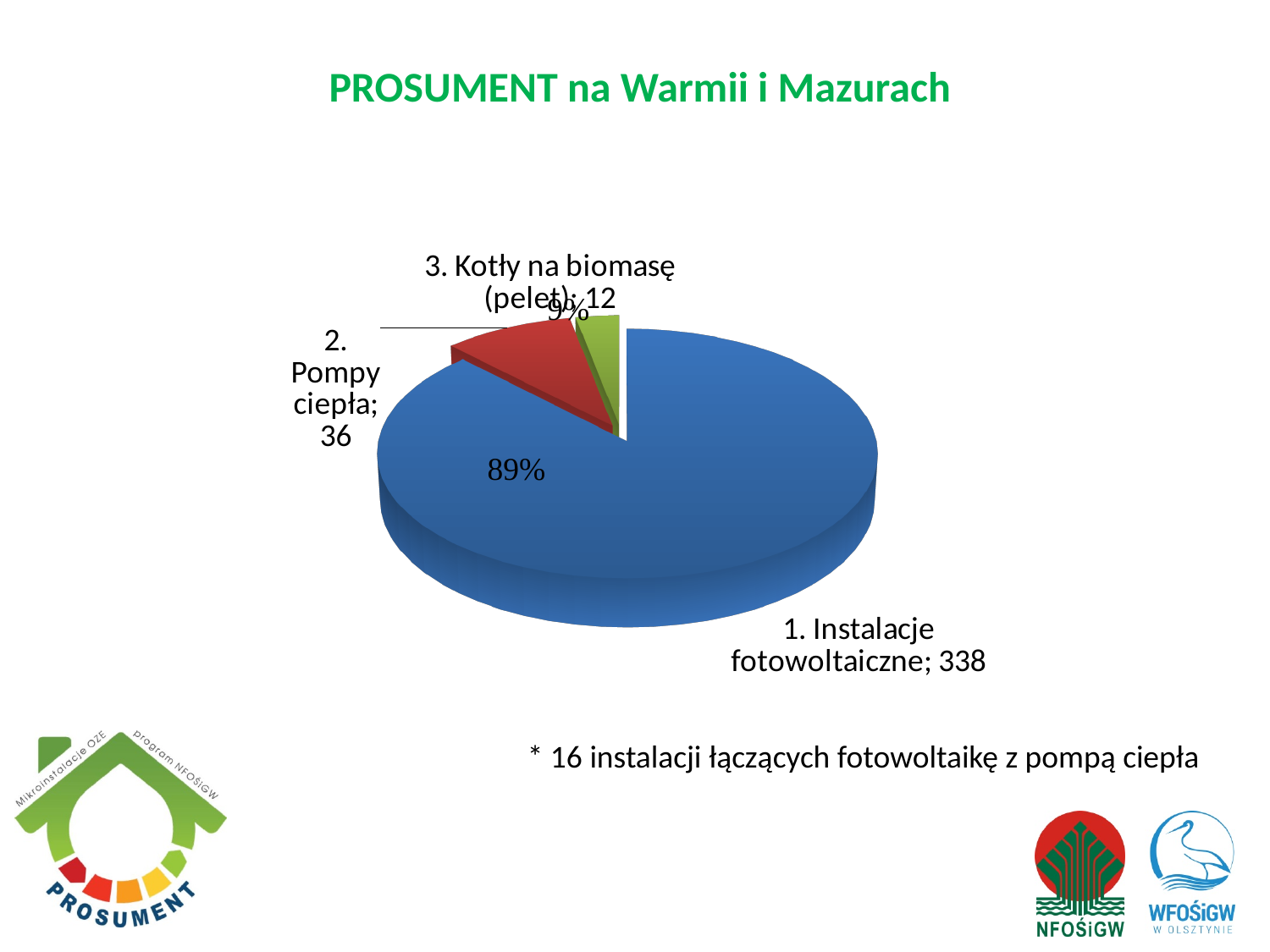
What is the difference between the values for "2. Pompy ciepła" and "3. Kotły na biomasę (pelet)"? 24 What is the title of the slide containing the pie chart? PROSUMENT na Warmii i Mazurach Which category has the smallest slice of the pie? 3. Kotły na biomasę (pelet) What is the value for "2. Pompy ciepła"? 36 What is the value for "3. Kotły na biomasę (pelet)"? 12 Which category has the largest slice of the pie? 1. Instalacje fotowoltaiczne Which is larger, the value for "2. Pompy ciepła" or for "3. Kotły na biomasę (pelet)"? 2. Pompy ciepła What percentage share is labelled on the "1. Instalacje fotowoltaiczne" slice? 89% How many slices does the pie chart have? 3 What is the value for "1. Instalacje fotowoltaiczne"? 338 What type of chart is shown on the slide? pie chart What is the difference between the values for "1. Instalacje fotowoltaiczne" and "2. Pompy ciepła"? 302